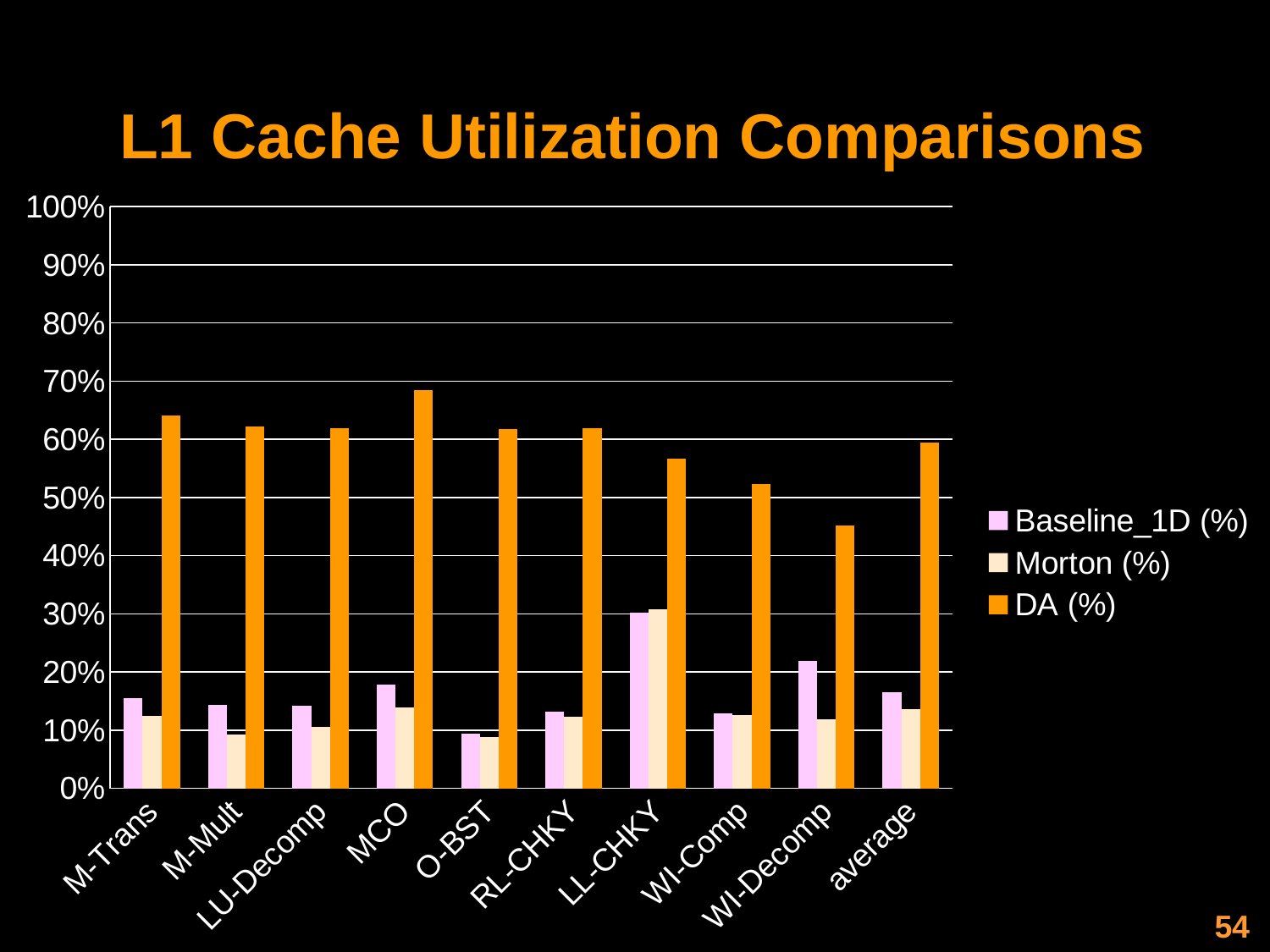
Which category has the lowest DA (%) value? WI-Decomp Is the DA (%) value for MCO greater or less than 60%? greater Which category has the highest DA (%) value? MCO Which category has the highest Morton (%) value? LL-CHKY For WI-Decomp, which is larger: the Baseline_1D (%) value or the Morton (%) value? Baseline_1D (%) What is the title of the chart? L1 Cache Utilization Comparisons Which category has the lowest Baseline_1D (%) value? O-BST What kind of chart is shown on the slide? bar chart How many series does the legend list? 3 How many categories are shown on the x axis? 10 Which category has the highest Baseline_1D (%) value? LL-CHKY Is the DA (%) value for WI-Decomp greater or less than 50%? less